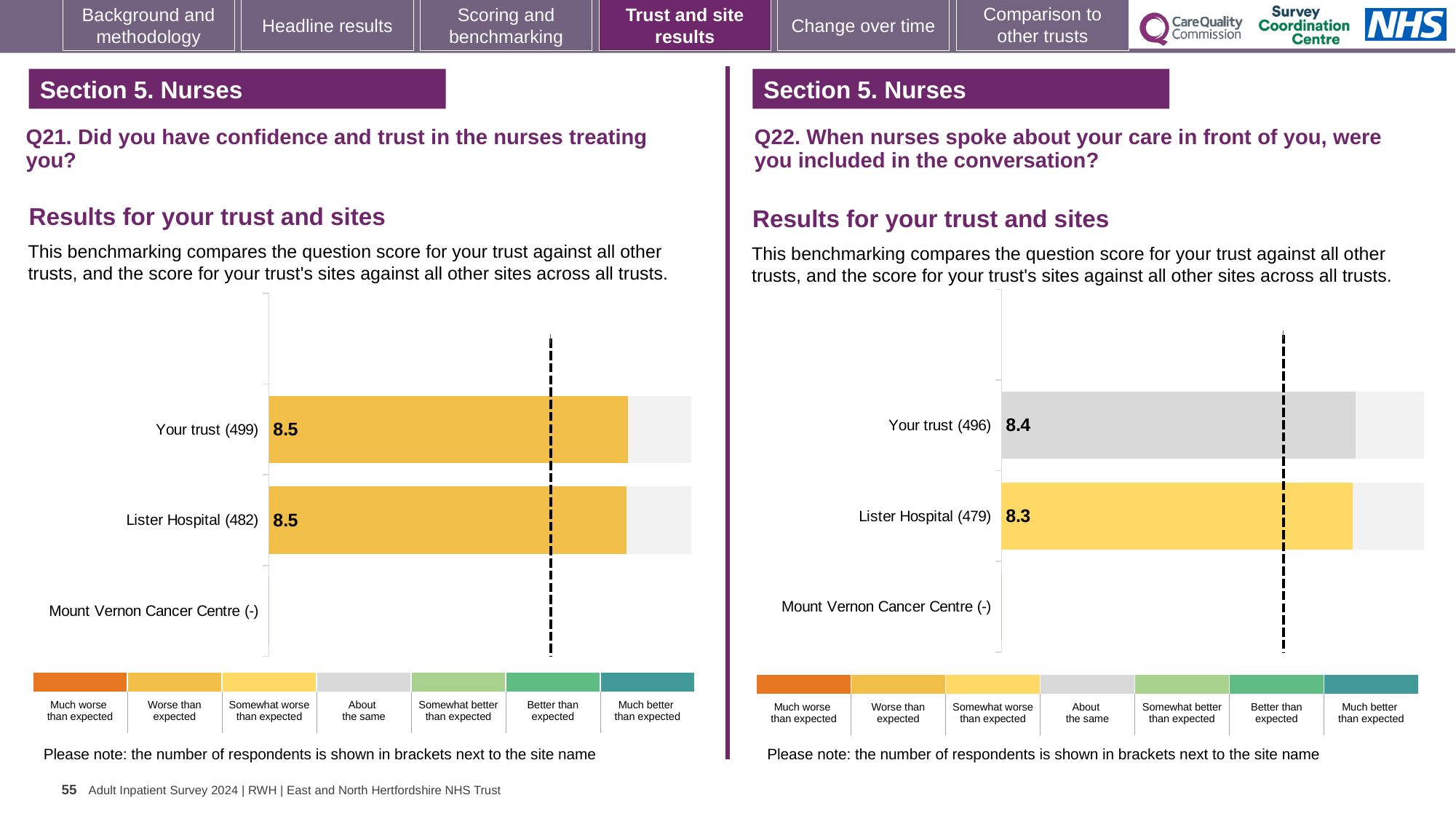
What kind of chart is used for the Q22 results on the right? Bar chart In the Q21 chart on the left, what is the score for Your trust? 8.5 In the Q22 chart on the right, which has the higher score, Your trust or Lister Hospital? Your trust How many site/trust categories are listed on the y axis of the Q21 chart on the left? 3 In the Q22 chart on the right, how many respondents are shown in brackets for Your trust? 496 In the Q22 chart on the right, which benchmark category does the colour of the Your trust bar correspond to? About the same In the Q21 chart on the left, which benchmark category does the colour of the Lister Hospital bar correspond to? Worse than expected In the Q22 chart on the right, what is the score for Your trust? 8.4 In the Q21 chart on the left, what is the score for Lister Hospital? 8.5 In the Q22 chart on the right, what is the score for Lister Hospital? 8.3 In the Q21 chart on the left, how many respondents are shown in brackets for Lister Hospital? 482 In the Q22 chart on the right, what is the difference between the scores for Your trust and Lister Hospital? 0.1